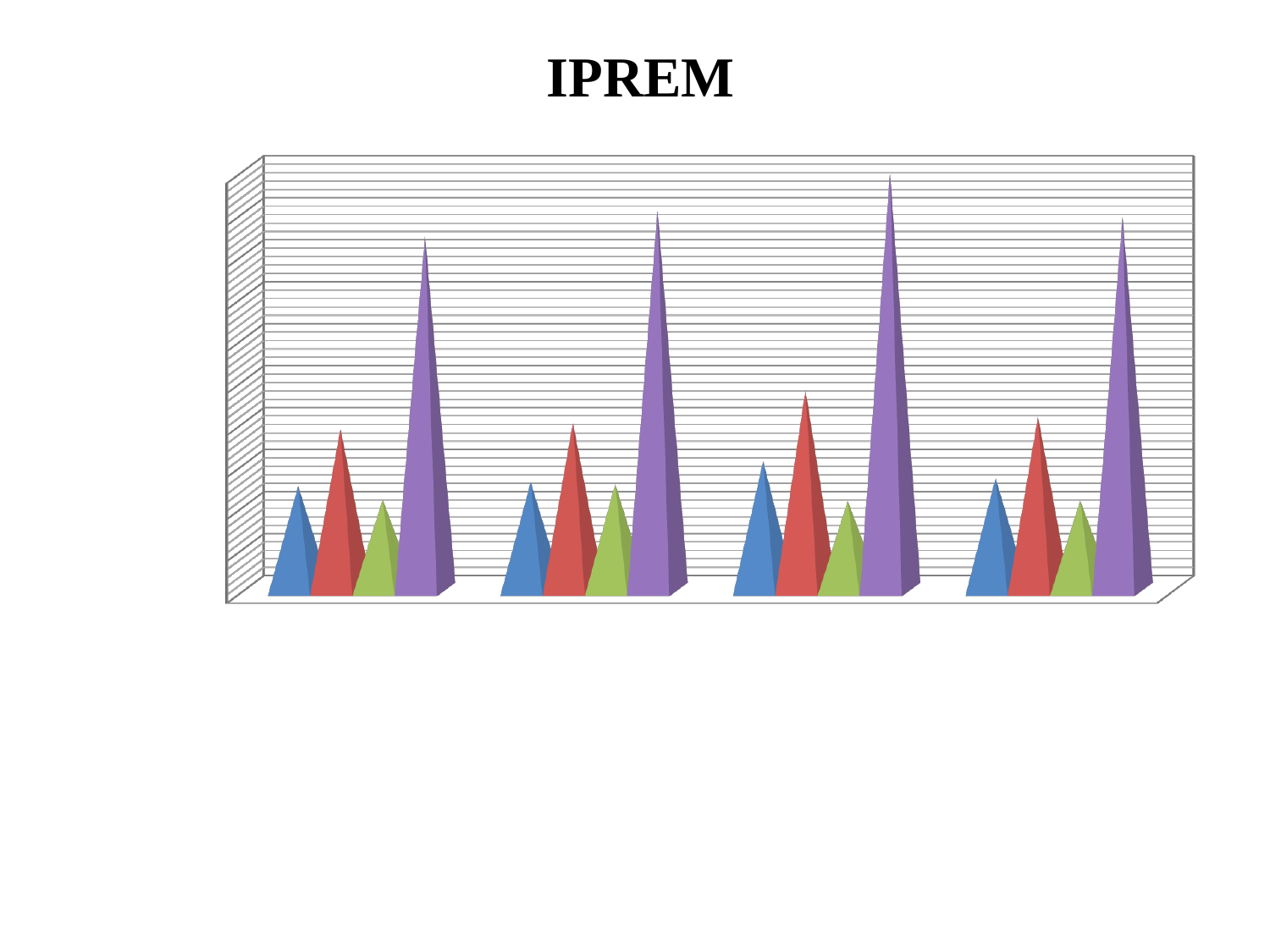
Which group, counting from the left, has the tallest purple bar? third In the third group from the left, which is taller, the purple bar or the red bar? purple Which group, counting from the left, has the shortest purple bar? first In the third group from the left, which colour of bar is the shortest? green Which colour of bar is the tallest in every group? purple How many groups of bars are plotted along the x axis? 4 Does the chart display a legend? No In the first group from the left, which is taller, the red bar or the blue bar? red What kind of chart is shown on the slide? bar chart How many differently coloured bars appear in each group? 4 What is the title of the chart? IPREM